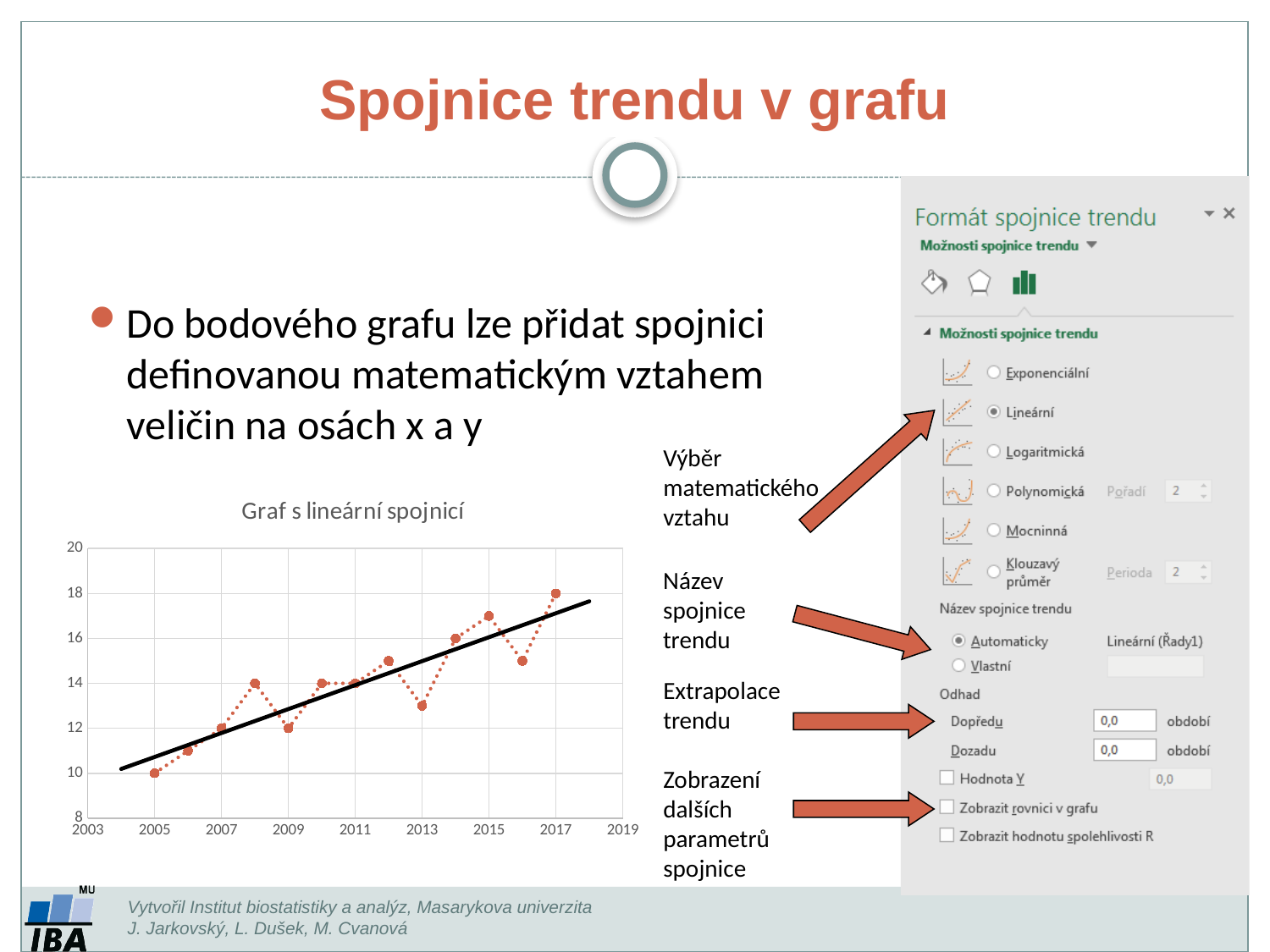
What is the difference between the values for 2017 and 2005? 8 Which year has the highest data point? 2017 What is the value of the data point for 2007? 12 Is the value for 2015 greater or less than 16? greater What is the value of the data point for 2005? 10 Which is larger, the value for 2017 or the value for 2005? 2017 What kind of chart is shown on the slide? scatter chart with a linear trendline Is the value for 2013 greater or less than 14? less Do the data points generally rise or fall from 2005 to 2017? rise Which year has the lowest data point? 2005 What is the value of the data point for 2017? 18 What is the title of the chart on the slide? Graf s lineární spojnicí